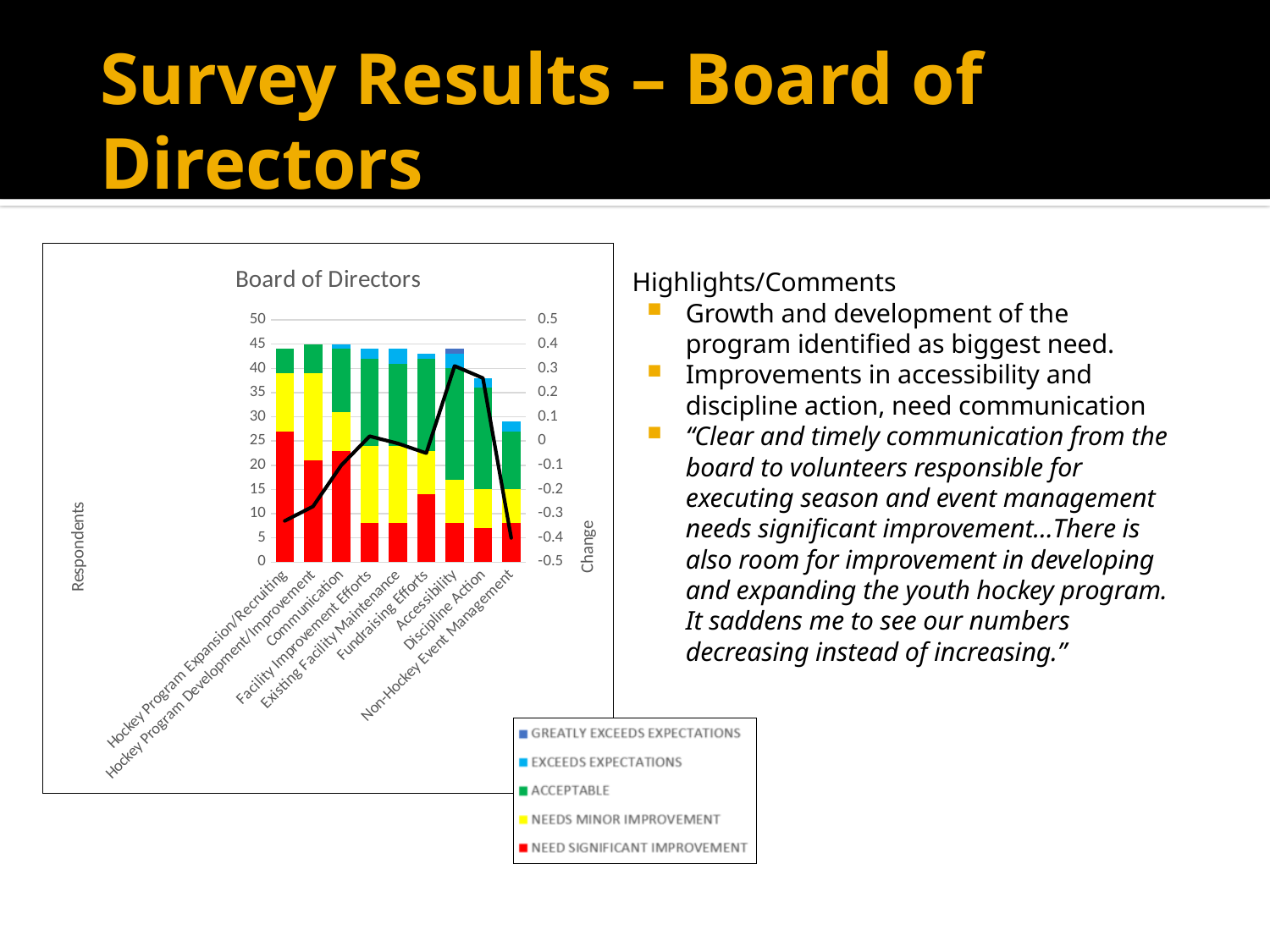
Is the total bar height for Accessibility greater or less than 40? greater Is the Change line value for Discipline Action greater or less than 0? greater Which category has the lowest total bar height in the Board of Directors chart? Non-Hockey Event Management Is the NEED SIGNIFICANT IMPROVEMENT value for Hockey Program Expansion/Recruiting greater or less than 20? greater How many series does the legend of the Board of Directors chart list? 5 What is the title of the chart? Board of Directors How many categories are shown along the x axis of the Board of Directors chart? 9 What kind of chart is shown on the slide? Stacked bar chart with a line overlay Which has a larger NEED SIGNIFICANT IMPROVEMENT value, Fundraising Efforts or Accessibility? Fundraising Efforts What is the label on the left vertical axis of the chart? Respondents Does the Change line rise or fall between Discipline Action and Non-Hockey Event Management? fall